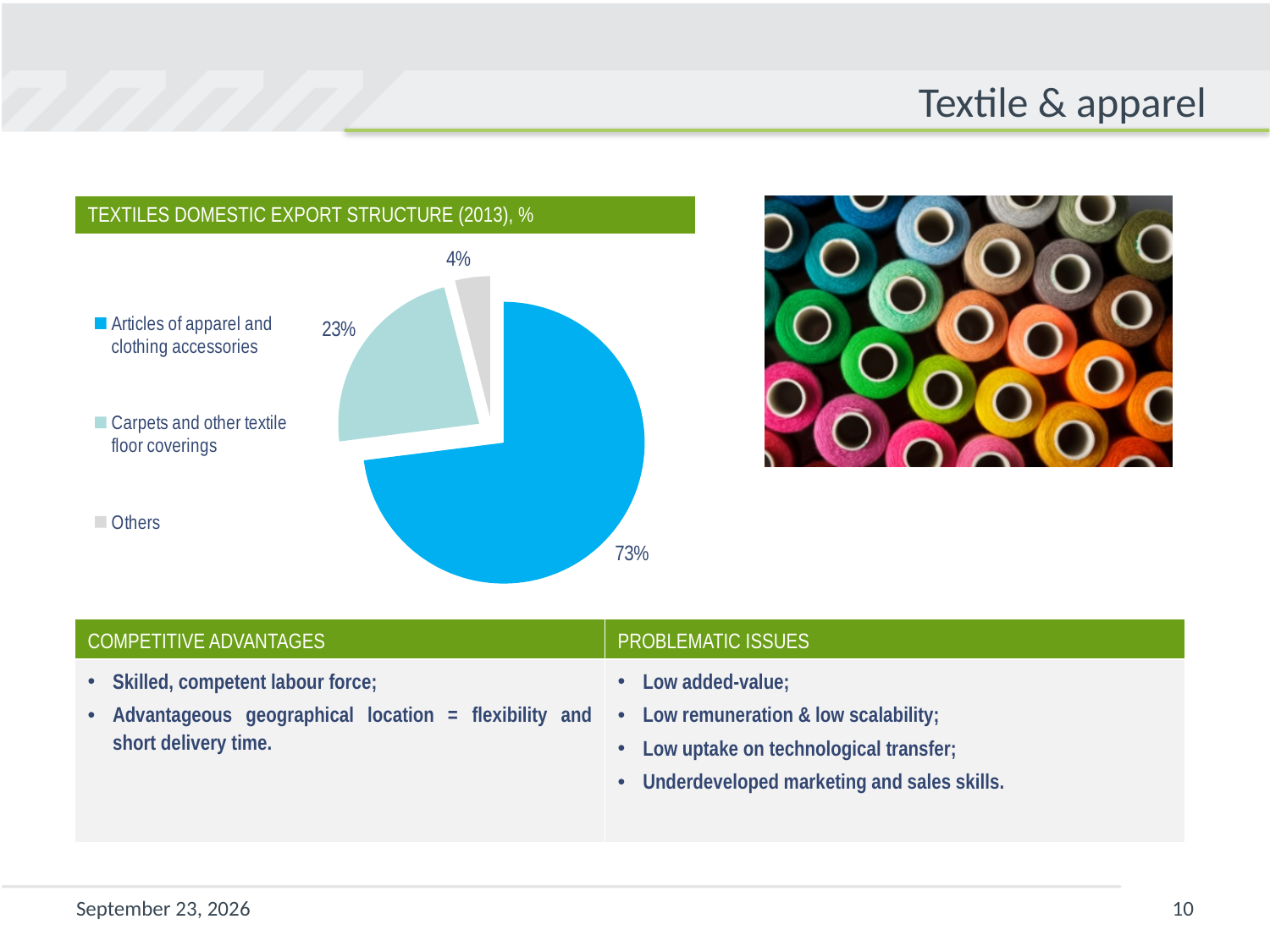
What type of chart is shown under the heading 'TEXTILES DOMESTIC EXPORT STRUCTURE (2013), %'? Pie chart How many entries does the legend of the pie chart list? 3 What is the title of the pie chart? TEXTILES DOMESTIC EXPORT STRUCTURE (2013), % Which category has the largest share of the pie? Articles of apparel and clothing accessories What colour is the slice for 'Articles of apparel and clothing accessories'? Blue What share of textiles domestic exports is 'Articles of apparel and clothing accessories'? 73% How many categories does the pie chart show? 3 What share of textiles domestic exports is 'Carpets and other textile floor coverings'? 23% What share of textiles domestic exports is 'Others'? 4% What is the difference in percentage points between 'Articles of apparel and clothing accessories' and 'Carpets and other textile floor coverings'? 50 percentage points Which is larger: the share for 'Carpets and other textile floor coverings' or the share for 'Others'? Carpets and other textile floor coverings Which category has the smallest share of the pie? Others